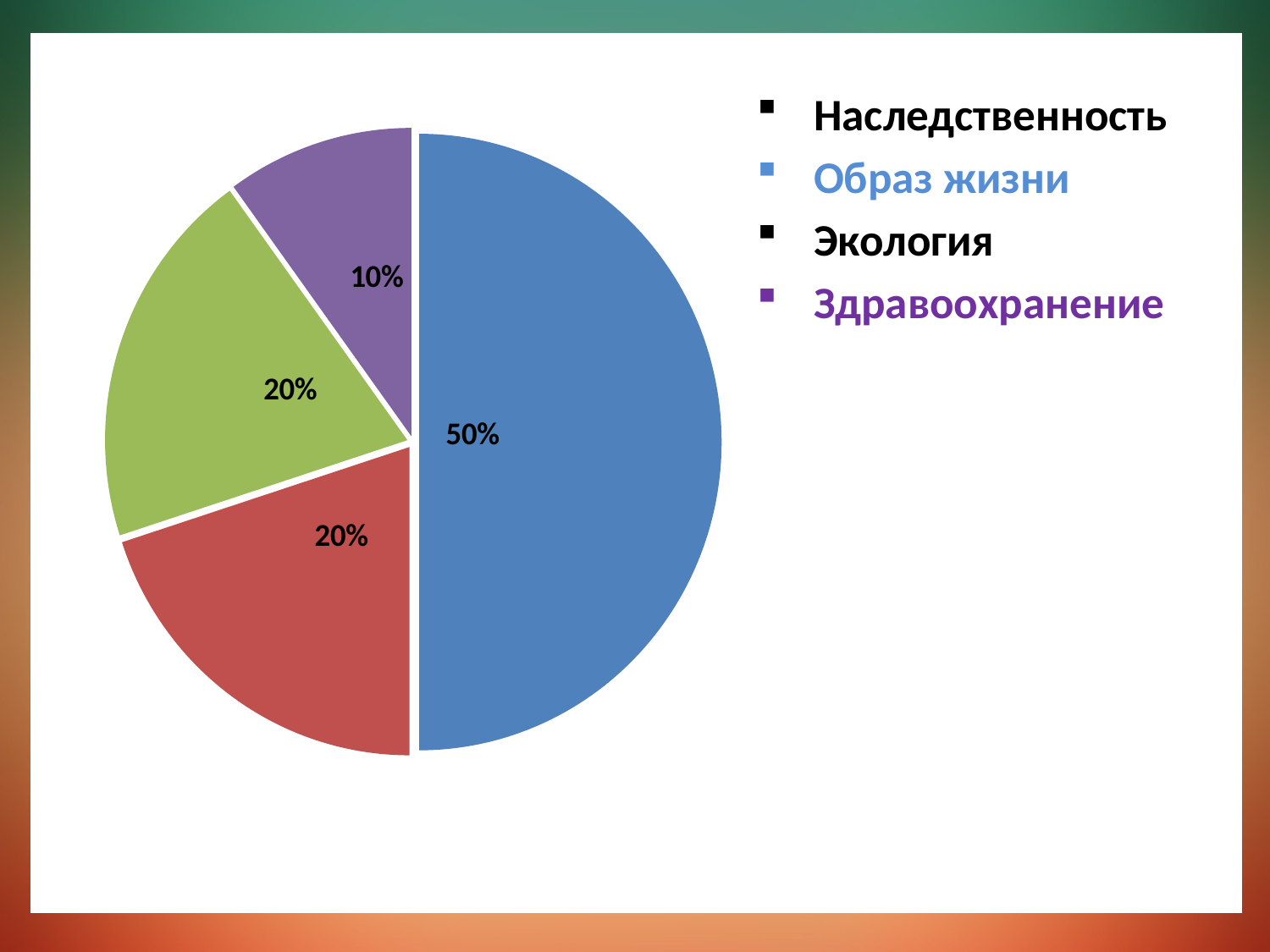
What type of chart is shown on the slide? pie chart How many entries are listed in the legend next to the pie chart? 4 What do the red and green slices add up to together? 40% What percentage is shown for Здравоохранение? 10% What percentage is shown on the green slice of the pie chart? 20% What percentage is shown for Образ жизни? 50% Which category has the largest slice of the pie chart? Образ жизни How many slices does the pie chart have? 4 Which category has the smallest slice of the pie chart? Здравоохранение What percentage is shown on the red slice of the pie chart? 20% Which is larger, the slice for Образ жизни or the slice for Здравоохранение? Образ жизни What is the difference in percentage points between Образ жизни and Здравоохранение? 40%